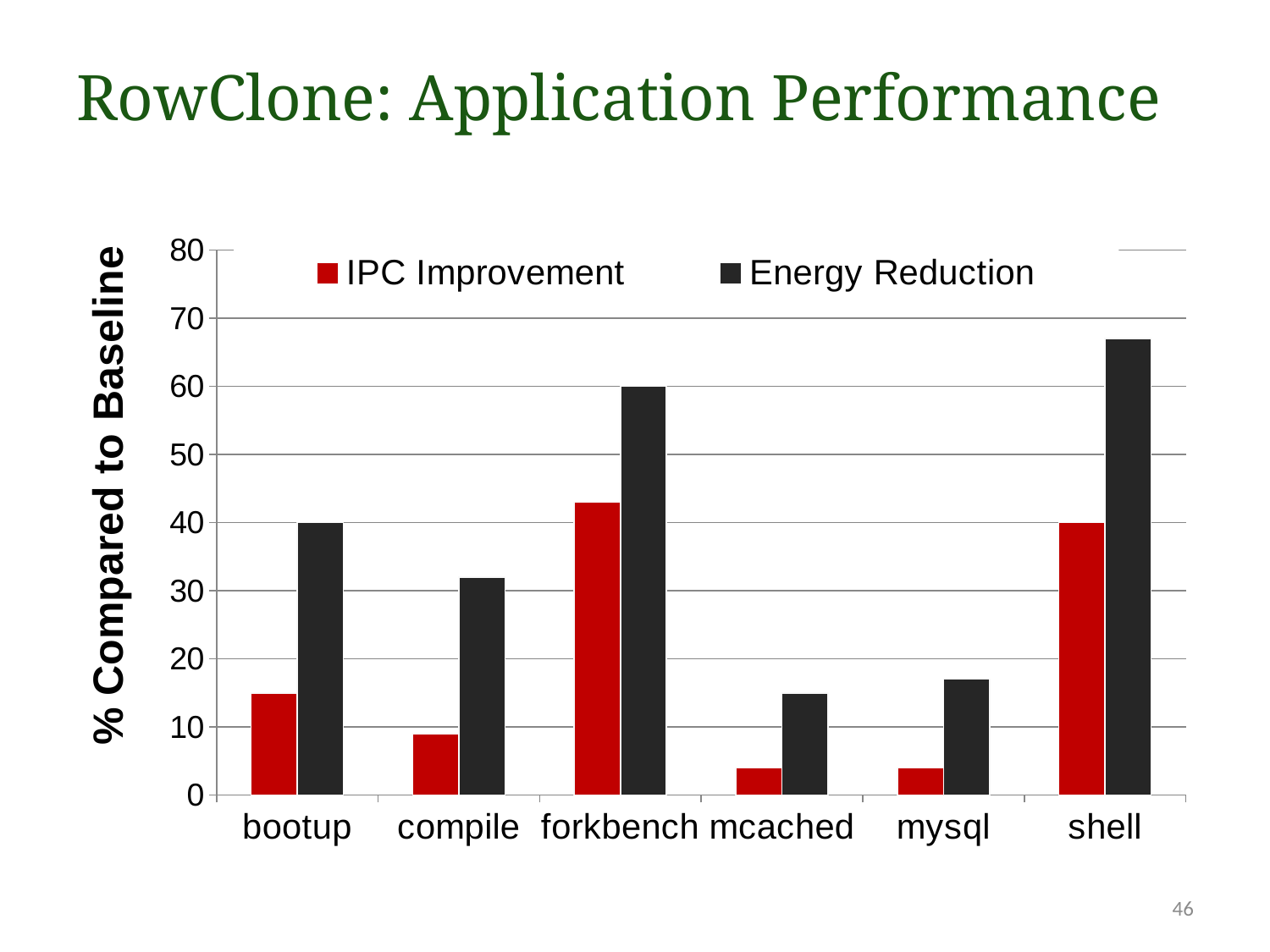
Is the Energy Reduction for compile greater or less than 30? greater Which application has the highest Energy Reduction? shell Which is larger: the Energy Reduction for bootup or the Energy Reduction for compile? bootup How many application categories are shown on the x axis? 6 What is the title of the y axis? % Compared to Baseline Which application has the highest IPC Improvement? forkbench Is the IPC Improvement for mcached greater or less than 10? less Is the IPC Improvement for forkbench greater or less than 40? greater What kind of chart is shown on the slide? bar chart How many series does the legend list? 2 What is the Energy Reduction value for bootup? 40